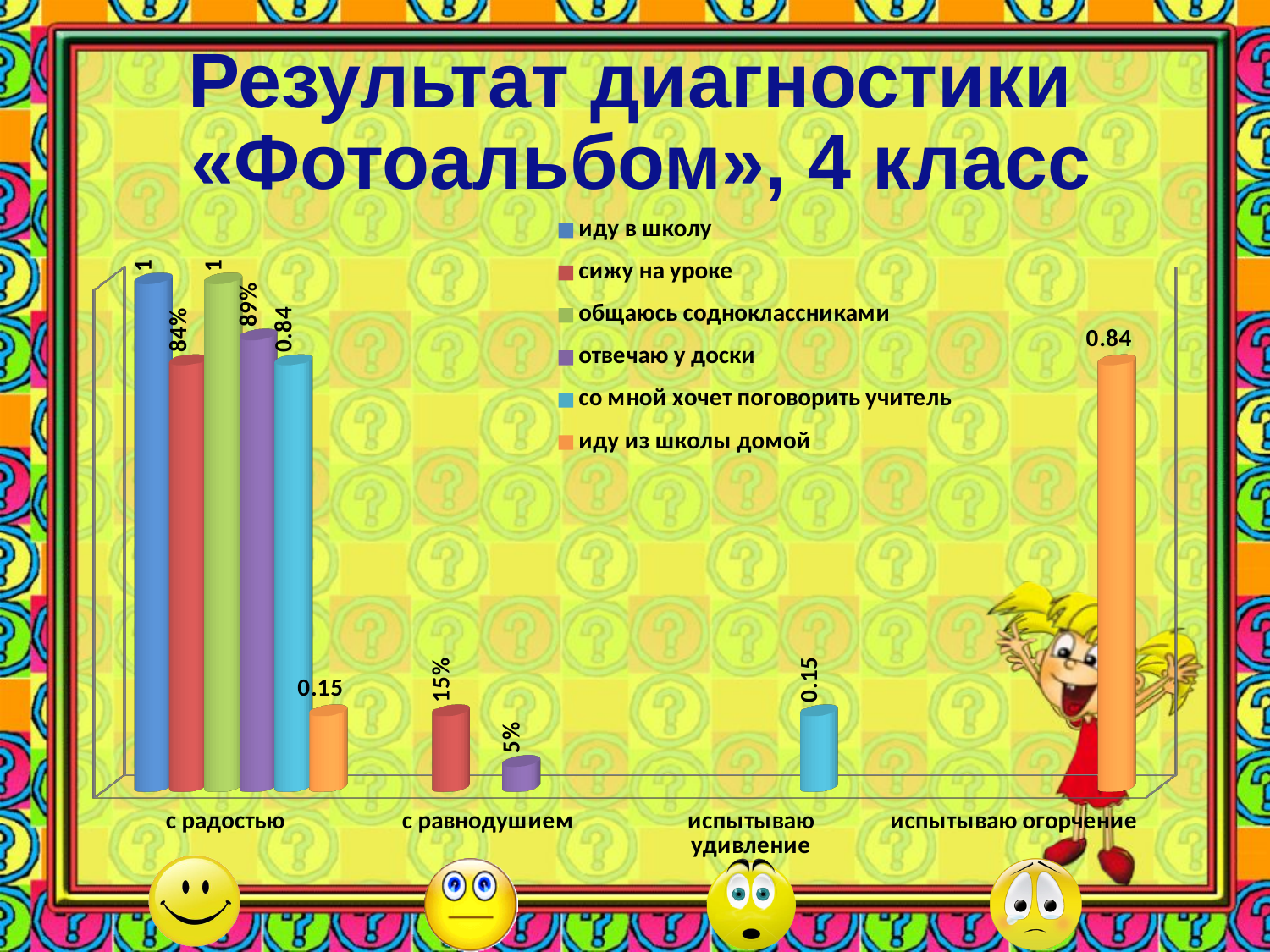
How many categories are shown along the x axis? 4 What is the value for «сижу на уроке» in the «с равнодушием» category? 15% In the «с равнодушием» category, which is larger: «сижу на уроке» or «отвечаю у доски»? сижу на уроке What is the value for «отвечаю у доски» in the «с радостью» category? 89% What kind of chart is shown on the slide? bar chart What is the value for «сижу на уроке» in the «с радостью» category? 84% What is the value for «иду из школы домой» in the «испытываю огорчение» category? 0.84 In the «с радостью» category, which series has the lowest value? иду из школы домой What is the title of the slide? Результат диагностики «Фотоальбом», 4 класс What is the value for «со мной хочет поговорить учитель» in the «испытываю удивление» category? 0.15 How many series does the legend list? 6 What is the value for «отвечаю у доски» in the «с равнодушием» category? 5%